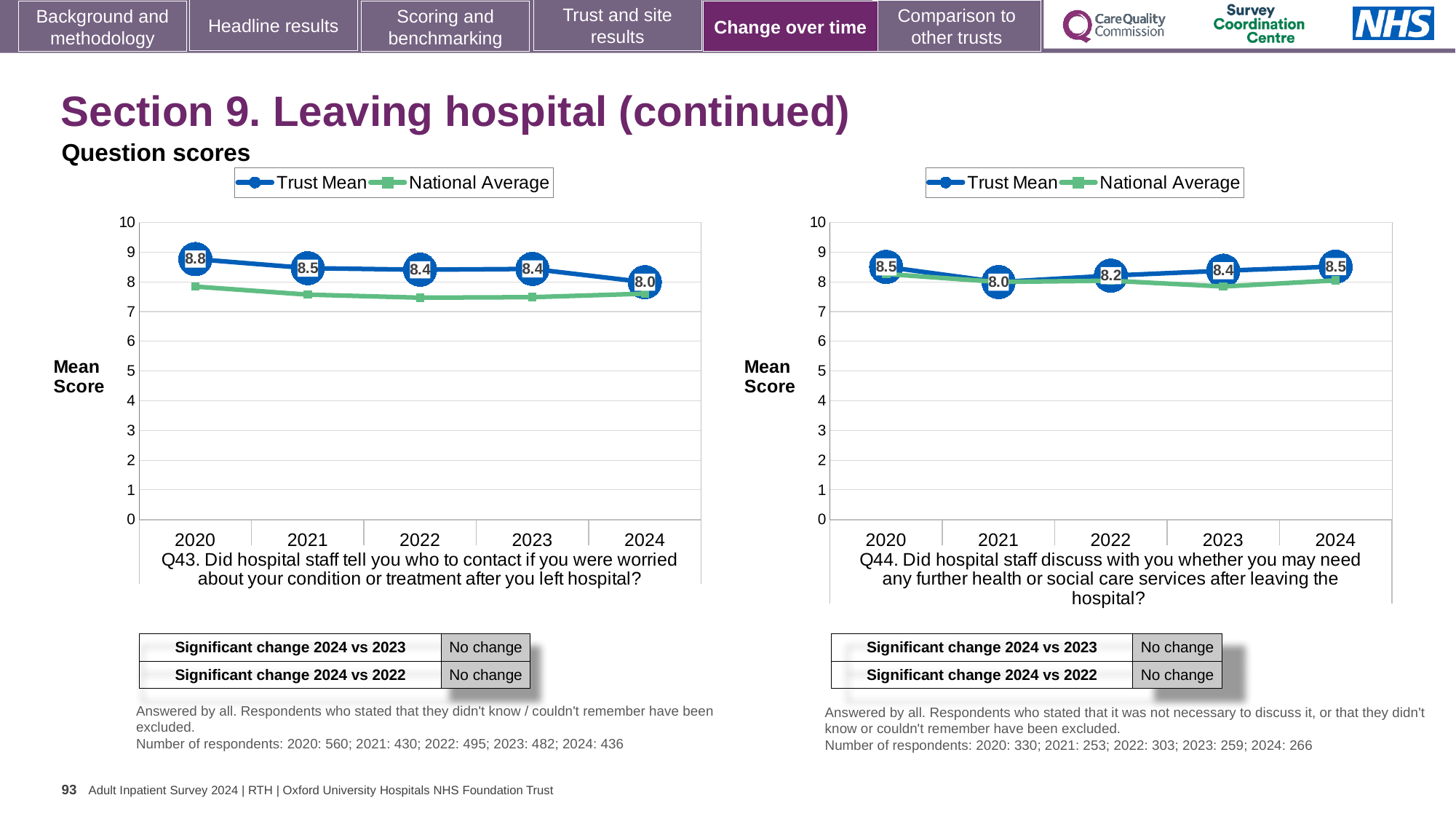
In the Q44 chart (right), which year has the lowest Trust Mean score? 2021 In the Q43 chart (left), is the Trust Mean for 2021 higher or lower than the Trust Mean for 2024? higher In the Q43 chart (left), which year has the highest Trust Mean score? 2020 In the Q43 chart (left), what is the Trust Mean score for 2020? 8.8 In the Q44 chart (right), what is the Trust Mean score for 2021? 8.0 In the Q43 chart (left), what is the difference between the Trust Mean scores for 2020 and 2024? 0.8 In the Q43 chart (left), what is the Trust Mean score for 2024? 8.0 In the Q43 chart (left), is the National Average value for 2022 greater or less than 8? less In the Q44 chart (right), what is the difference between the Trust Mean scores for 2024 and 2021? 0.5 What type of chart is used for Q43 (left)? Line chart How many series does the legend of the Q43 chart (left) list? 2 How many years are shown on the x axis of the Q44 chart (right)? 5